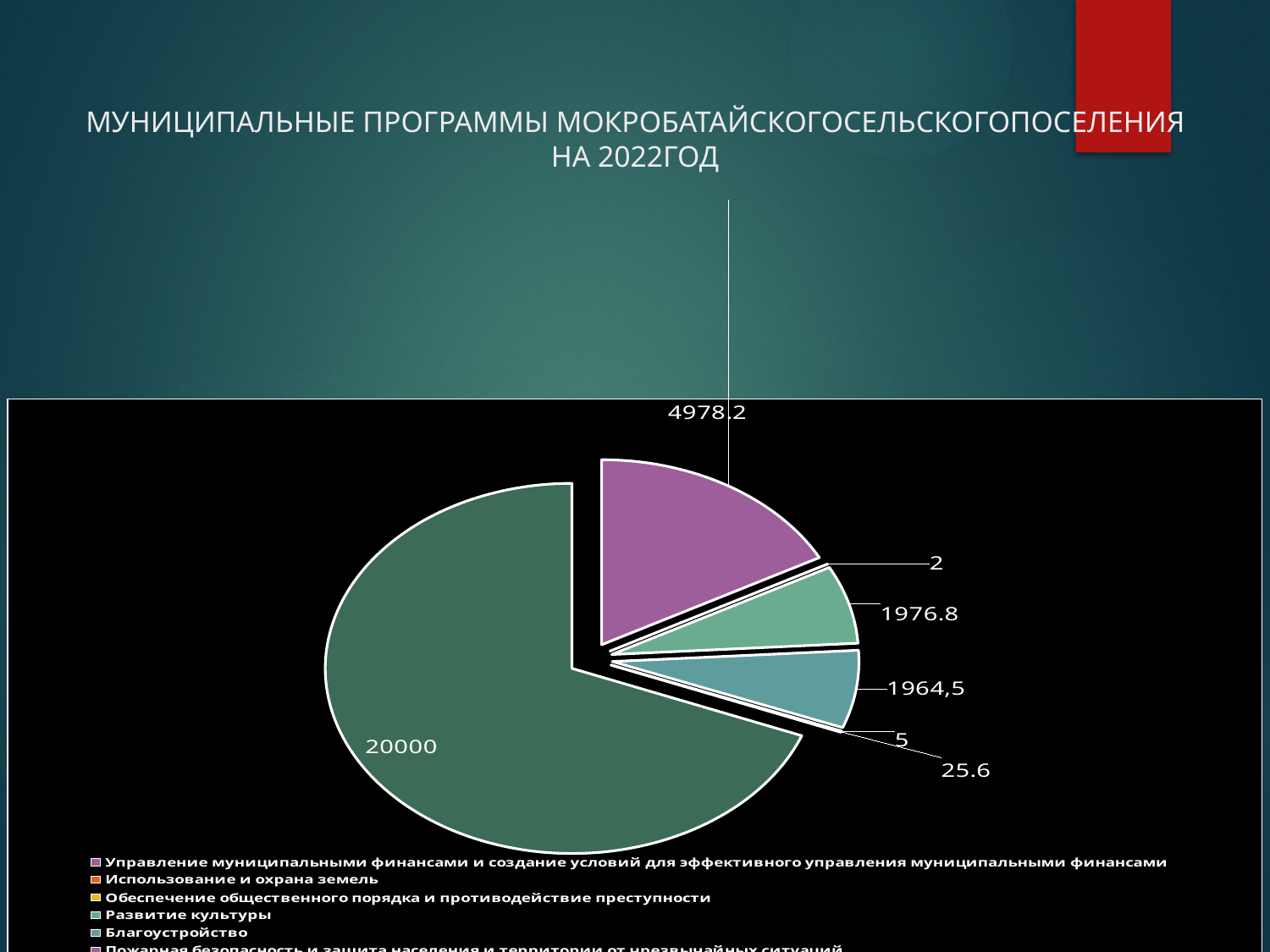
What is the value shown for the 'Благоустройство' slice? 1964,5 What is the smallest value labelled on the pie chart? 2 Which slice has the larger value, 'Развитие культуры' or 'Благоустройство'? Развитие культуры What is the difference between the largest labelled slice (20000) and the 'Управление муниципальными финансами...' slice (4978.2)? 15021.8 Which slice has the larger value, 'Управление муниципальными финансами...' or 'Развитие культуры'? Управление муниципальными финансами и создание условий для эффективного управления муниципальными финансами What is the value shown for the slice 'Управление муниципальными финансами и создание условий для эффективного управления муниципальными финансами'? 4978.2 What is the largest value labelled on the pie chart? 20000 What colour is the 'Управление муниципальными финансами...' slice in the pie chart? purple What is the title of the slide containing the pie chart? МУНИЦИПАЛЬНЫЕ ПРОГРАММЫ МОКРОБАТАЙСКОГОСЕЛЬСКОГОПОСЕЛЕНИЯ НА 2022ГОД What kind of chart is shown on the slide? pie chart What is the difference between the 'Управление муниципальными финансами...' slice (4978.2) and the 'Развитие культуры' slice (1976.8)? 3001.4 What is the value shown for the 'Развитие культуры' slice? 1976.8